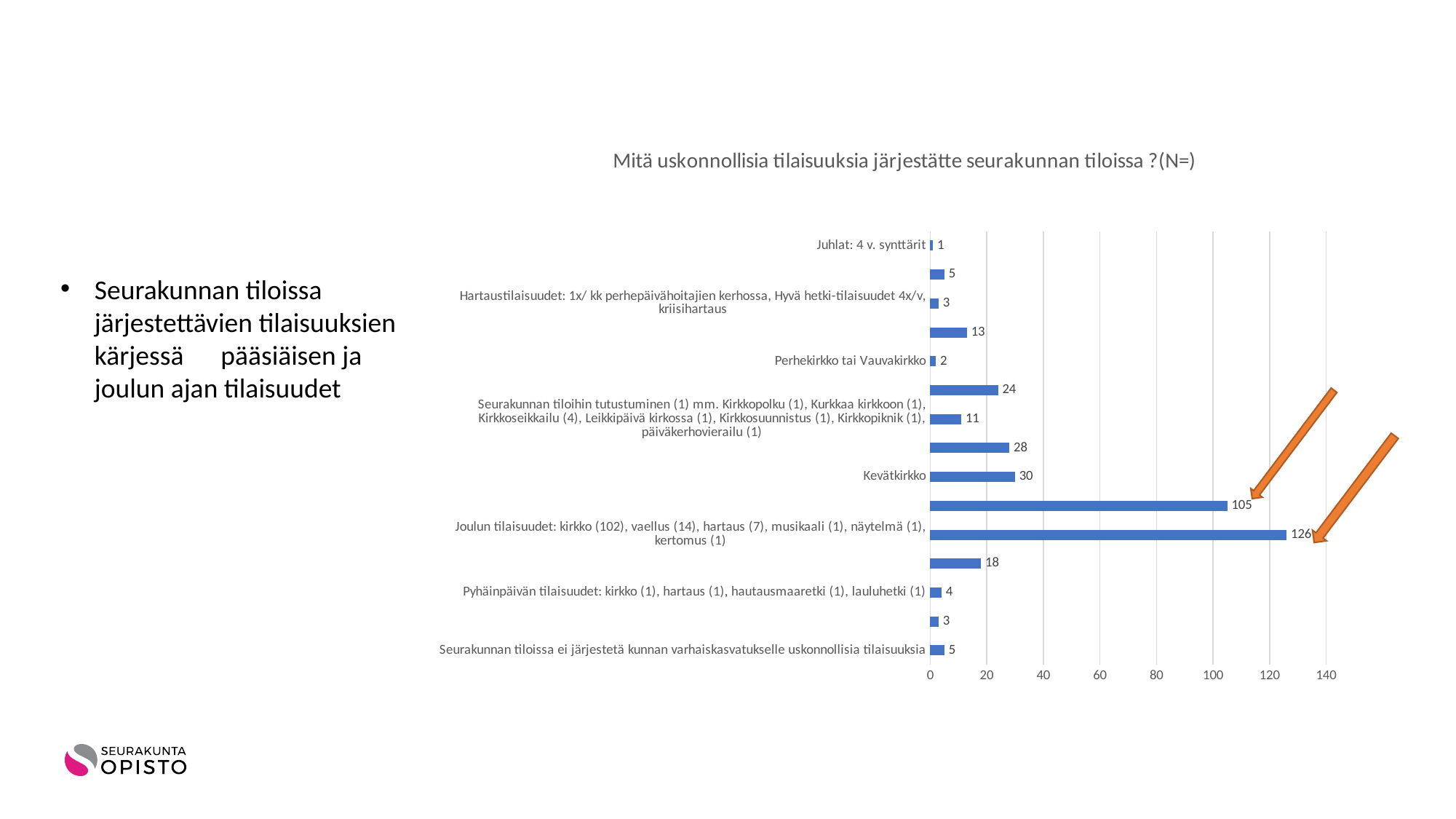
What is the value for Kevätkirkko? 30 Which labelled category has the lowest value? Juhlat: 4 v. synttärit What is the value for Perhekirkko tai Vauvakirkko? 2 Is the value for Joulun tilaisuudet greater or less than 120? greater Which labelled category has the highest value? Joulun tilaisuudet Which is larger, the value for Kevätkirkko or the value for Perhekirkko tai Vauvakirkko? Kevätkirkko How many bars are plotted in the chart? 15 What is the value for Juhlat: 4 v. synttärit? 1 What is the value for Seurakunnan tiloissa ei järjestetä kunnan varhaiskasvatukselle uskonnollisia tilaisuuksia? 5 What is the value for the bar labelled Joulun tilaisuudet? 126 What is the difference between the value for Joulun tilaisuudet and the value for Kevätkirkko? 96 What kind of chart is shown on the slide? Bar chart